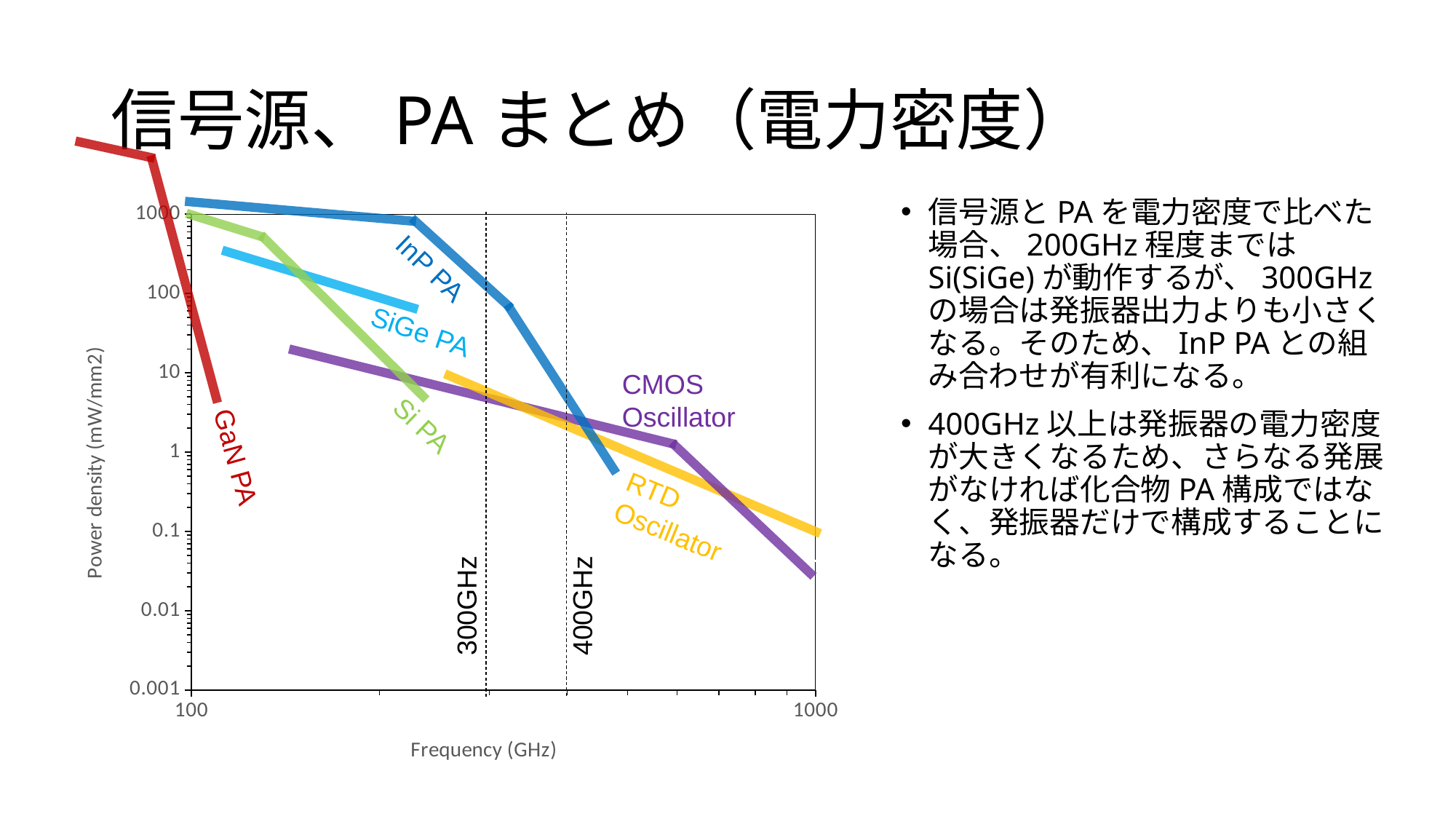
How many labeled series (lines) are plotted on the chart? 6 What is the label of the x axis of the chart? Frequency (GHz) Is the power density of the InP PA at 100 GHz greater or less than 1000 mW/mm2? greater What is the label of the y axis of the chart? Power density (mW/mm2) At what two frequencies are vertical dashed reference lines drawn on the chart? 300GHz and 400GHz What kind of chart is shown on the slide? line chart Is the power density of the CMOS Oscillator at 1000 GHz greater or less than 0.1 mW/mm2? less Is the power density of the InP PA at 400 GHz greater or less than 10 mW/mm2? less At 300 GHz, which has the higher power density: the InP PA or the CMOS Oscillator? InP PA Does the power density of the InP PA line rise or fall as frequency increases? fall At 1000 GHz, which has the higher power density: the RTD Oscillator or the CMOS Oscillator? RTD Oscillator